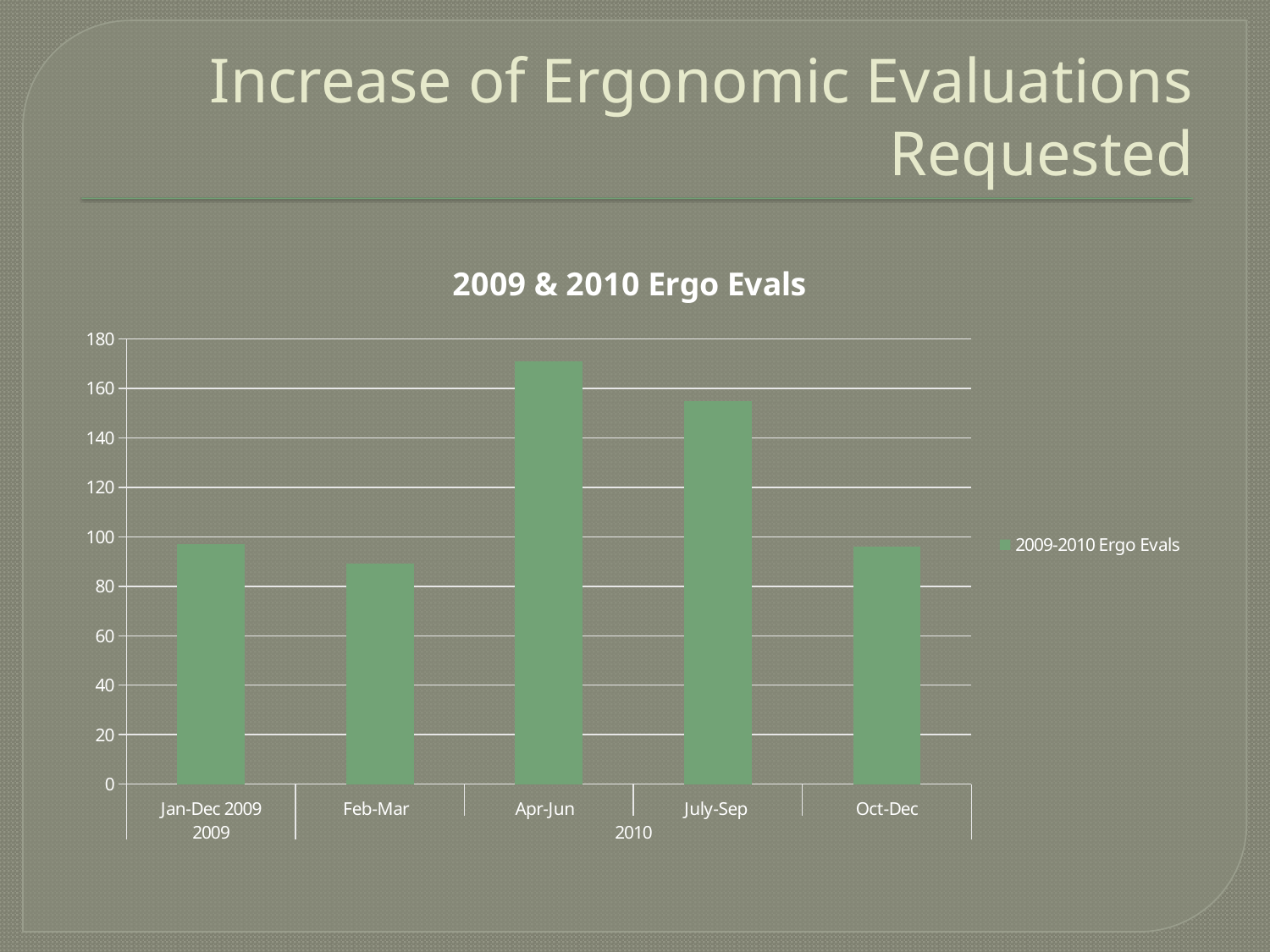
What series name is shown in the chart's legend? 2009-2010 Ergo Evals How many series does the chart's legend list? 1 Which category has the highest bar in the chart? Apr-Jun Is the value for Feb-Mar greater or less than 100? less What is the title of the chart? 2009 & 2010 Ergo Evals Which category has the lowest bar in the chart? Feb-Mar What kind of chart is shown on the slide? Bar chart How many categories are plotted on the x axis of the chart? 5 Which is larger, the value for Apr-Jun or the value for July-Sep? Apr-Jun Is the value for Jan-Dec 2009 greater or less than 80? greater Is the value for Apr-Jun greater or less than 160? greater